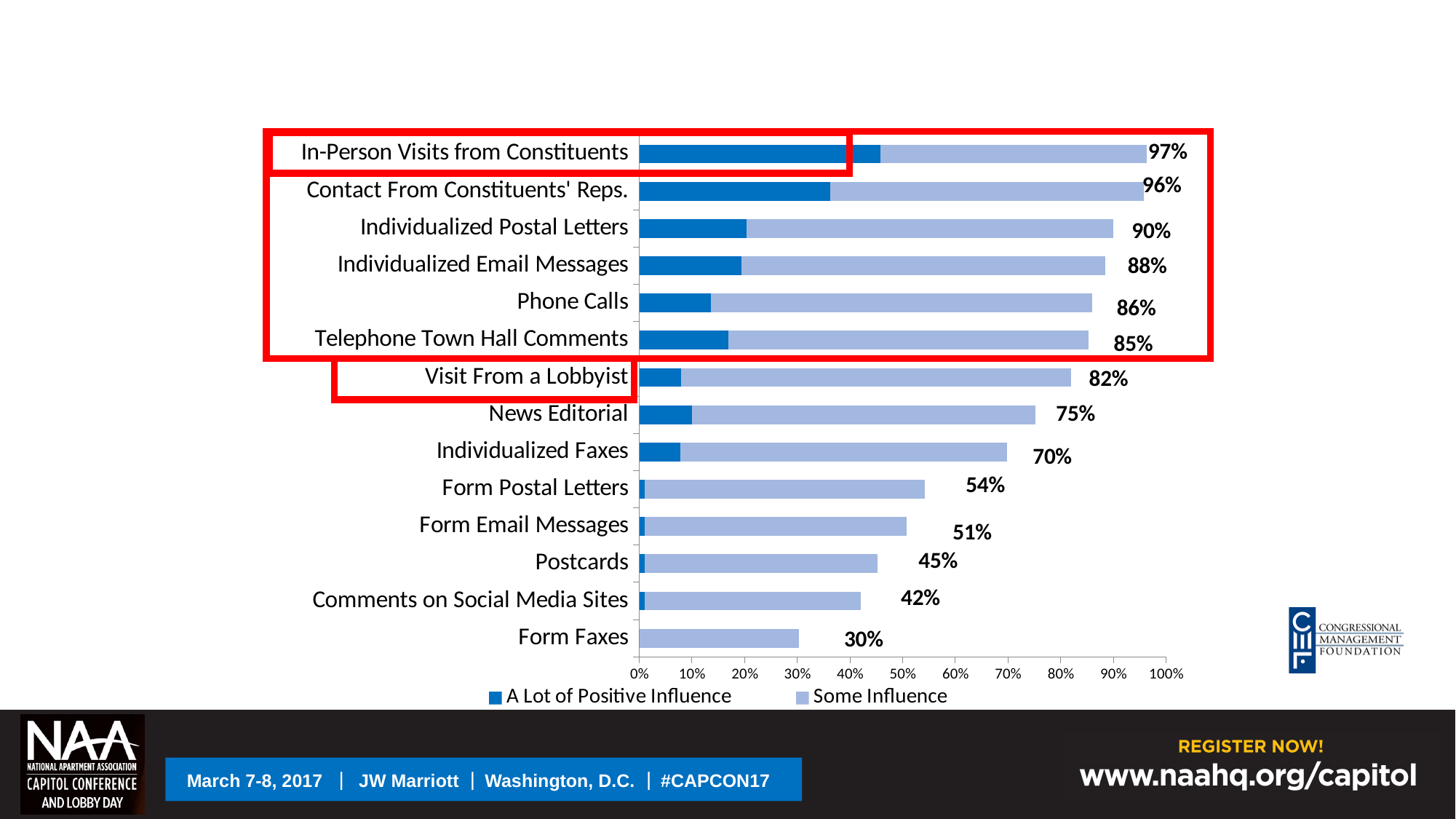
Is the 'A Lot of Positive Influence' value for Phone Calls greater or less than 20%? less What is the difference between the total percentages for In-Person Visits from Constituents and Form Faxes? 67 percentage points How many series does the legend list? 2 How many categories are plotted in the chart? 14 Which category has the highest total percentage? In-Person Visits from Constituents What is the total percentage shown for Visit From a Lobbyist? 82% Which category has the lowest total percentage? Form Faxes What kind of chart is shown on the slide? Stacked horizontal bar chart What is the total percentage shown for In-Person Visits from Constituents? 97% What is the total percentage shown for Form Faxes? 30% Is the 'A Lot of Positive Influence' value for In-Person Visits from Constituents greater or less than 40%? greater Which has a higher total percentage, News Editorial or Individualized Faxes? News Editorial